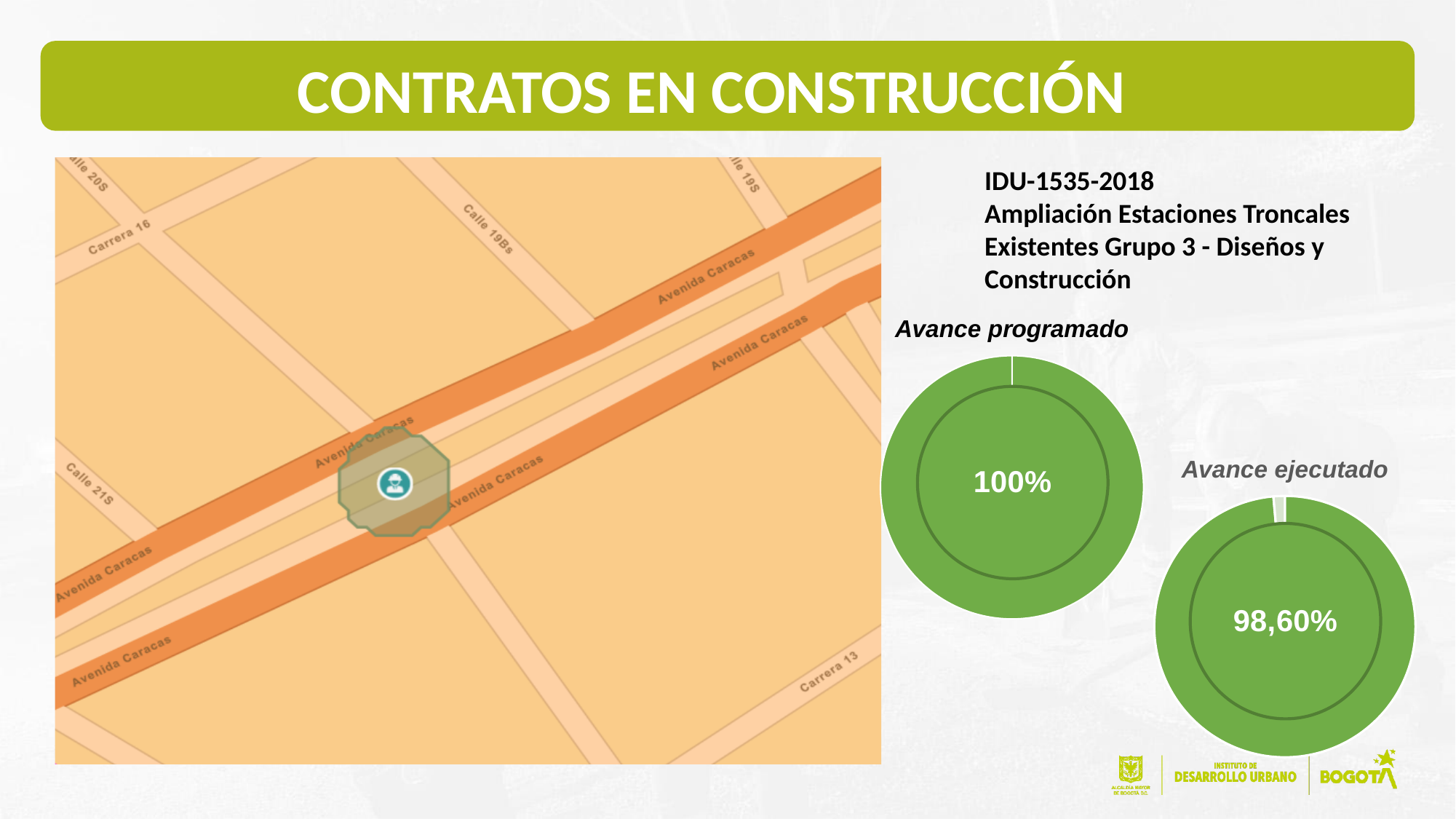
How many charts are shown on the slide? 2 In the 'Avance ejecutado' chart, is the value greater or less than 90%? greater What colour are the slices in the 'Avance programado' chart? Green Which chart has the lower value, 'Avance programado' or 'Avance ejecutado'? Avance ejecutado In the 'Avance programado' chart, what value is shown? 100% In the 'Avance ejecutado' chart, what value is shown? 98,60% In the 'Avance ejecutado' chart, what share of the pie does the large green slice represent? 98,60% Which chart shows the larger value, 'Avance programado' or 'Avance ejecutado'? Avance programado What is the title of the chart on the right side of the slide, below the 'Avance programado' chart? Avance ejecutado What is the difference between the value in the 'Avance programado' chart and the value in the 'Avance ejecutado' chart? 1,40% What kind of chart is the 'Avance ejecutado' chart? Doughnut chart